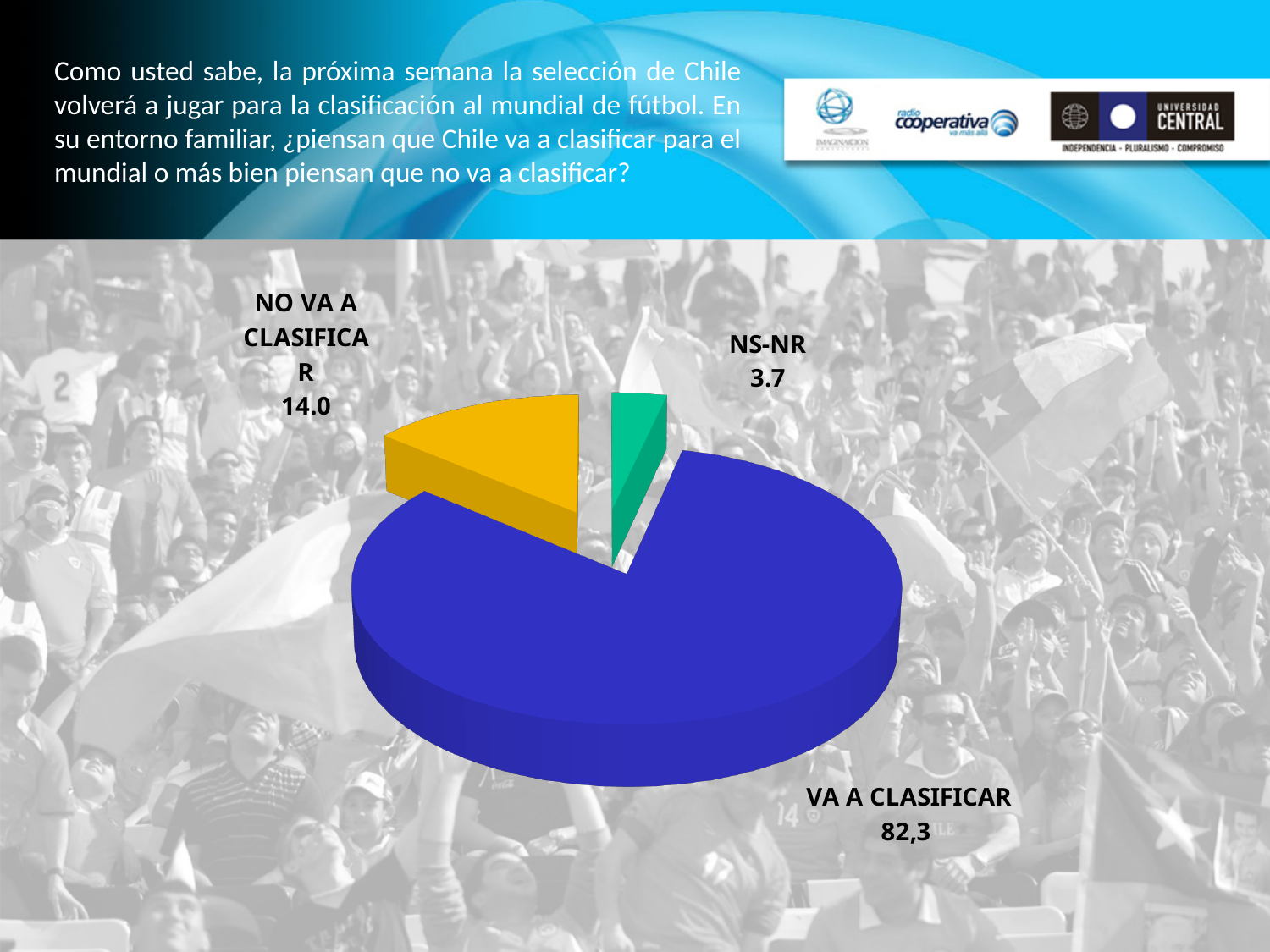
What colour is the NO VA A CLASIFICAR slice? yellow Which category has the smallest slice of the pie? NS-NR Which category has the largest slice of the pie? VA A CLASIFICAR How many slices does the pie chart have? 3 What is the difference between the values for NO VA A CLASIFICAR and NS-NR? 10.3 What colour is the VA A CLASIFICAR slice? blue Which is larger, NO VA A CLASIFICAR or NS-NR? NO VA A CLASIFICAR What kind of chart is shown on the slide? pie chart What is the value shown for NS-NR? 3.7 What is the value shown for VA A CLASIFICAR? 82,3 What is the value shown for NO VA A CLASIFICAR? 14.0